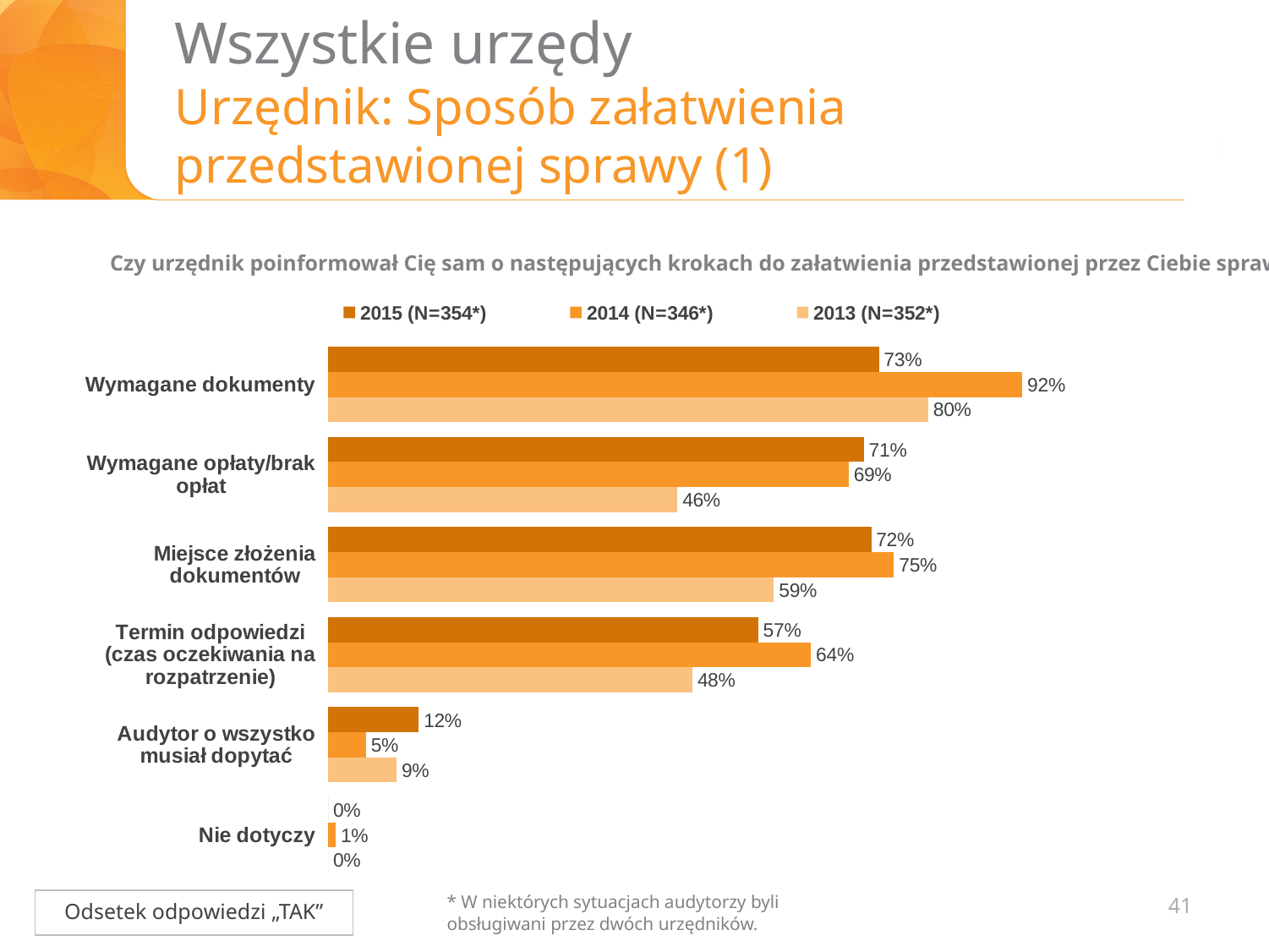
What is the difference between the 2014 (N=346*) and 2015 (N=354*) values for "Wymagane dokumenty"? 19% What kind of chart is shown on the slide? Bar chart Which category has the highest value in the 2015 (N=354*) series? Wymagane dokumenty What is the value for "Wymagane dokumenty" in the 2014 (N=346*) series? 92% What is the value for "Wymagane opłaty/brak opłat" in the 2013 (N=352*) series? 46% For "Miejsce złożenia dokumentów", which series has the larger value: 2014 (N=346*) or 2013 (N=352*)? 2014 (N=346*) Which category has the lowest value in the 2014 (N=346*) series? Nie dotyczy How many series does the legend list? 3 How many categories are shown on the chart? 6 What is the value for "Audytor o wszystko musiał dopytać" in the 2014 (N=346*) series? 5% What is the value for "Termin odpowiedzi (czas oczekiwania na rozpatrzenie)" in the 2015 (N=354*) series? 57% What is the difference between the 2015 (N=354*) and 2013 (N=352*) values for "Termin odpowiedzi (czas oczekiwania na rozpatrzenie)"? 9%